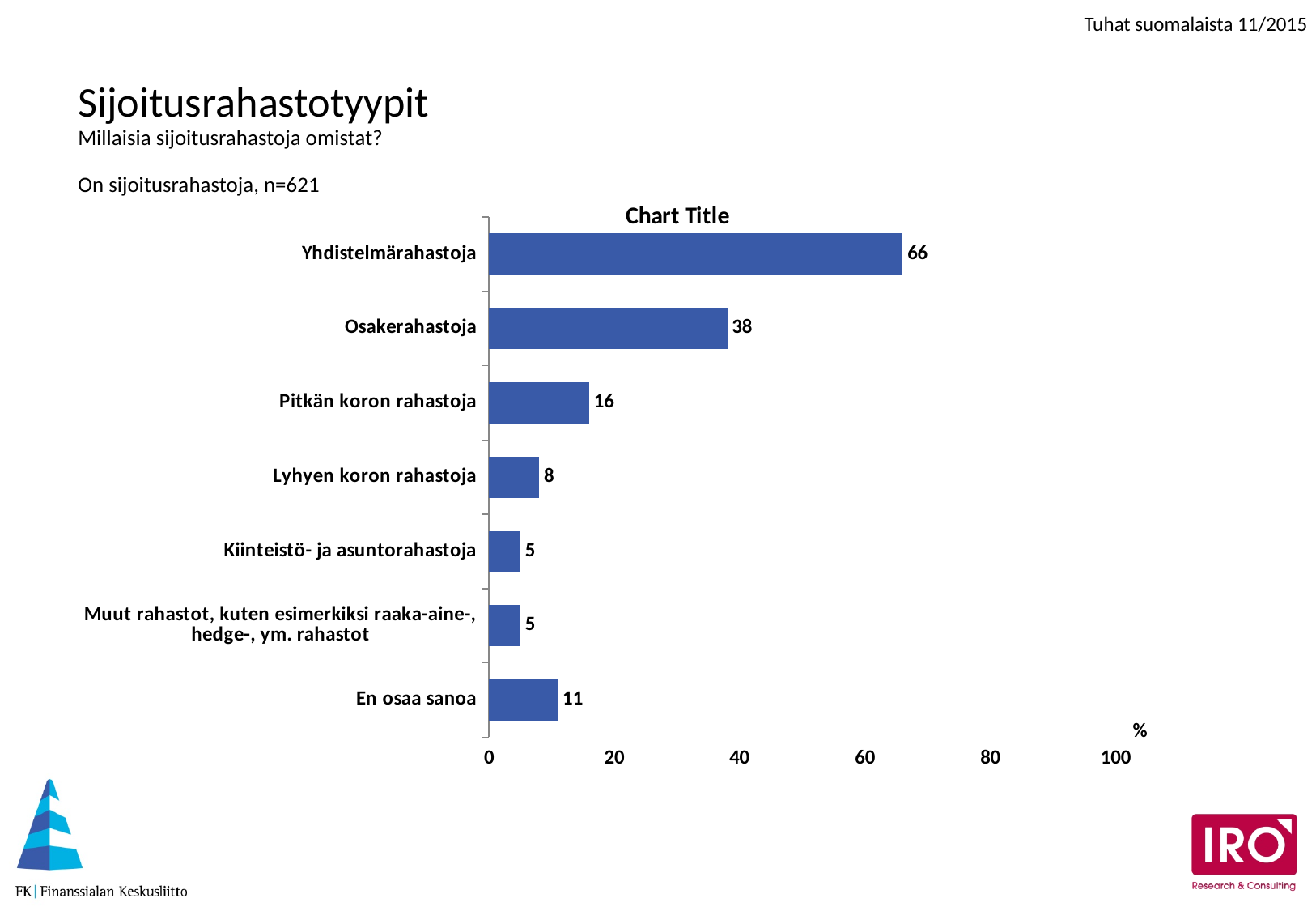
What is the value for En osaa sanoa? 11 What is the value for Osakerahastoja? 38 What is the difference between the values for Yhdistelmärahastoja and Osakerahastoja? 28 How many categories are shown in the chart? 7 What is the value for Yhdistelmärahastoja? 66 Which category has the highest value? Yhdistelmärahastoja What kind of chart is shown on the slide? bar chart What is the difference between the values for Pitkän koron rahastoja and Lyhyen koron rahastoja? 8 What is the value for Pitkän koron rahastoja? 16 Which is larger, the value for En osaa sanoa or the value for Lyhyen koron rahastoja? En osaa sanoa What is the title shown above the chart? Chart Title Is the value for Osakerahastoja greater or less than 40? less